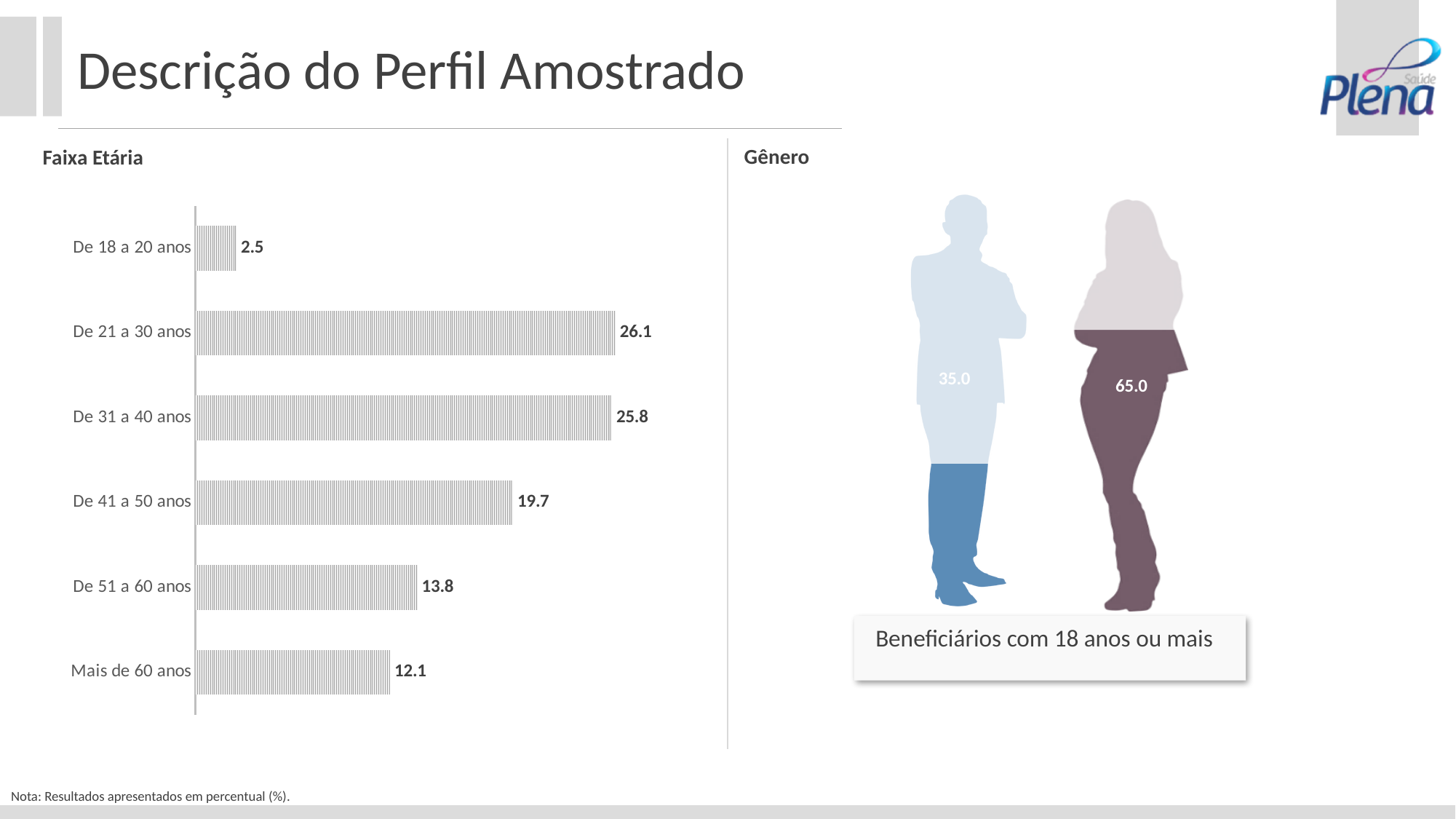
In the Gênero graphic, what is the value shown on the female figure? 65.0 In the Faixa Etária chart, which age group has the lowest value? De 18 a 20 anos In the Faixa Etária chart, which age group has the highest value? De 21 a 30 anos In the Faixa Etária chart, what is the value for De 41 a 50 anos? 19.7 In the Faixa Etária chart, what is the value for De 21 a 30 anos? 26.1 In the Faixa Etária chart, from De 21 a 30 anos down to Mais de 60 anos, do the values rise or fall? Fall In the Faixa Etária chart, what is the difference between De 21 a 30 anos and De 31 a 40 anos? 0.3 What kind of chart is the Faixa Etária chart? Bar chart In the Faixa Etária chart, what is the value for Mais de 60 anos? 12.1 How many age groups are shown in the Faixa Etária chart? 6 In the Faixa Etária chart, which is larger: De 51 a 60 anos or Mais de 60 anos? De 51 a 60 anos In the Faixa Etária chart, what is the difference between De 41 a 50 anos and De 51 a 60 anos? 5.9